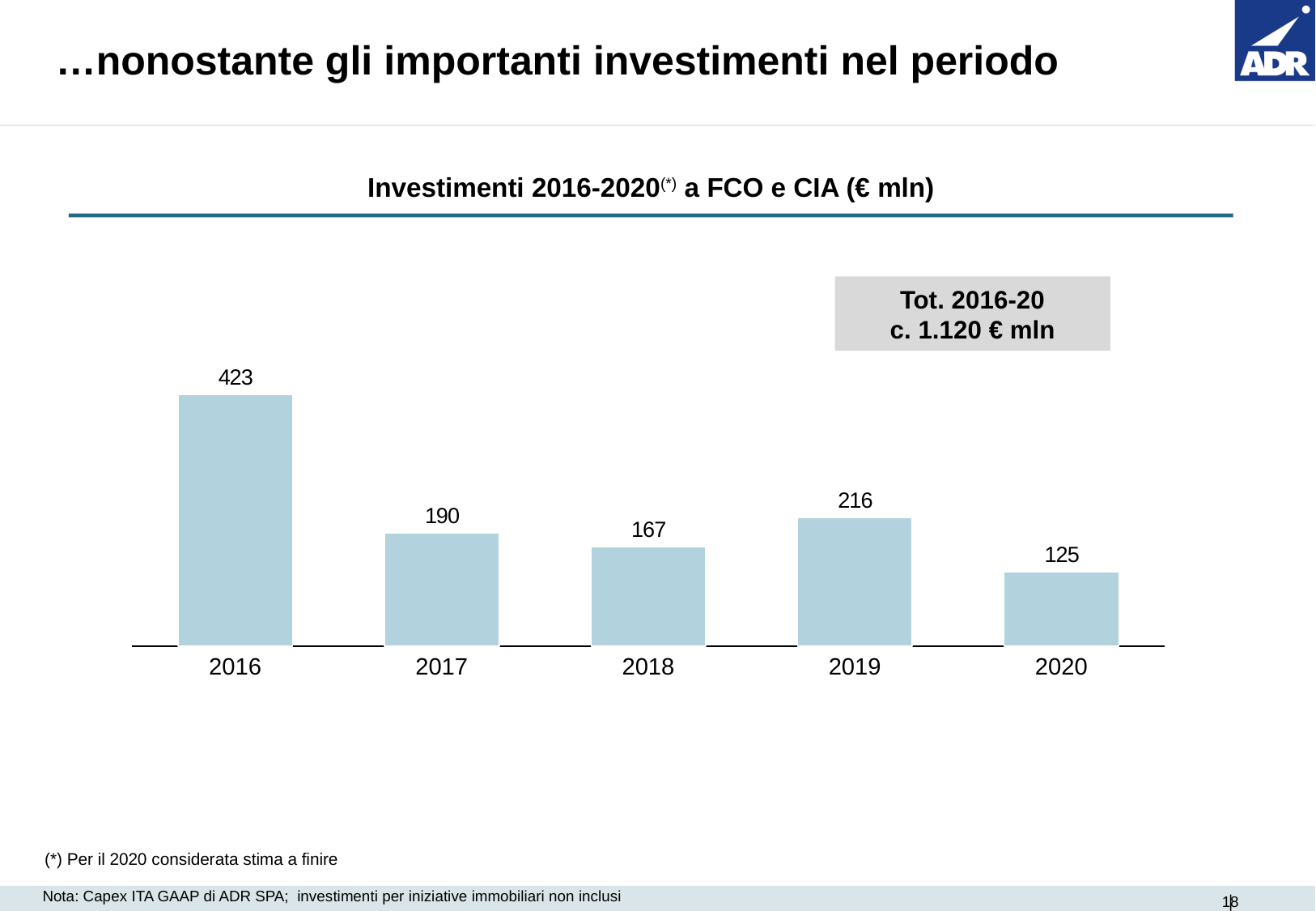
What total for 2016-20 is stated in the box on the chart? c. 1.120 € mln What is the difference between the investment values for 2019 and 2020? 91 What kind of chart is shown on the slide? Bar chart What is the difference between the investment values for 2016 and 2017? 233 What is the investment value for 2018? 167 Which year has the lowest investment value? 2020 Do the investment values rise or fall from 2016 to 2018? Fall How many years are shown on the chart? 5 Which year has the highest investment value? 2016 Which is larger, the investment value for 2017 or for 2019? 2019 What is the investment value for 2020? 125 What is the investment value for 2016? 423